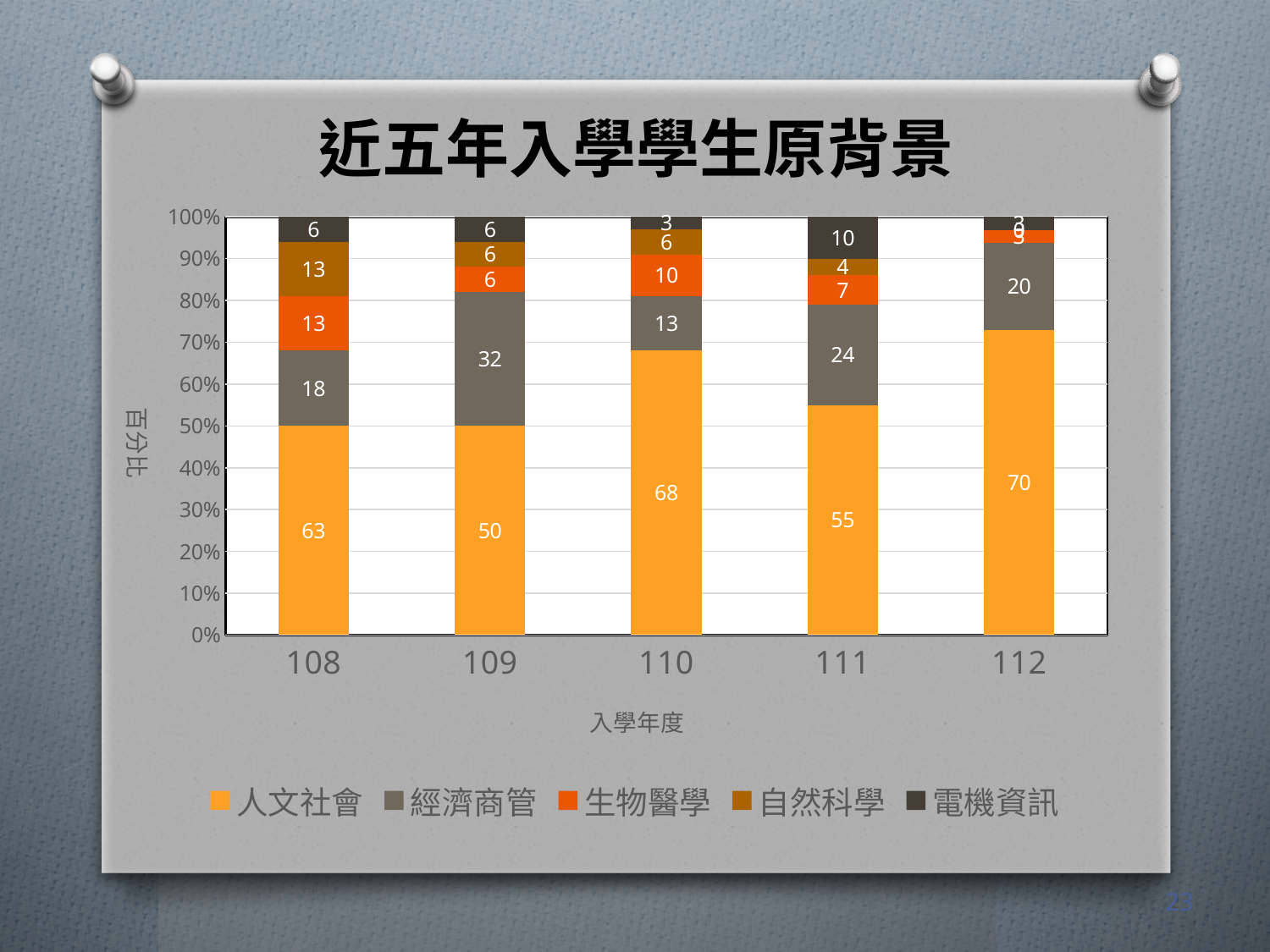
What is the value of 電機資訊 for 111? 10 What kind of chart is shown on the slide? Stacked bar chart What is the value of 經濟商管 for 109? 32 Which year has the highest value for 人文社會? 112 What is the value of 生物醫學 for 108? 13 Which year has the larger 經濟商管 value, 108 or 111? 111 What is the title of the chart? 近五年入學學生原背景 How many years are shown on the x axis? 5 How many series does the legend list? 5 What is the value of 人文社會 for 110? 68